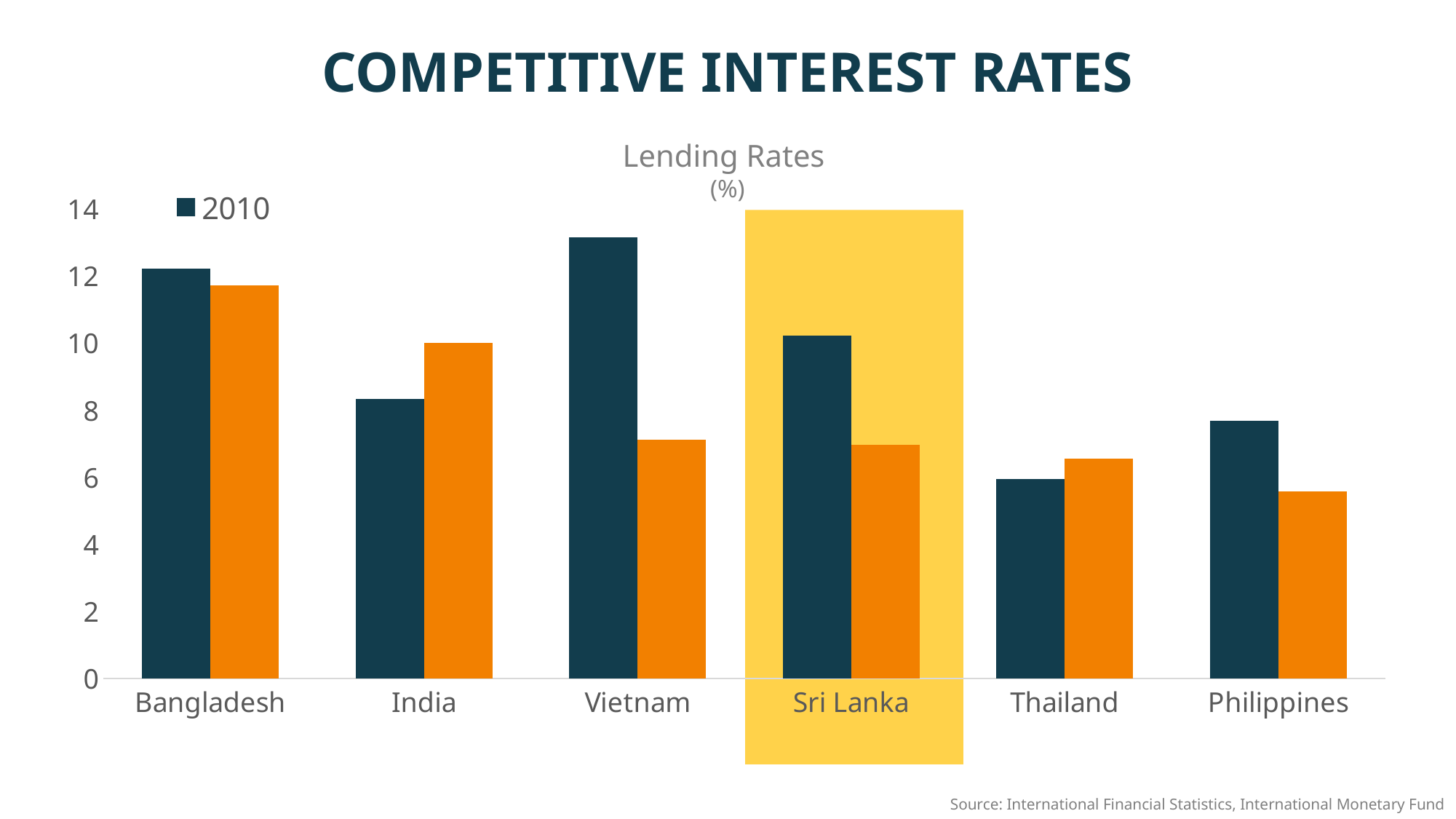
For India, which bar is taller, the dark blue 2010 bar or the orange bar? the orange bar Which country has the lowest 2010 lending rate? Thailand Which country is highlighted with a yellow box on the chart? Sri Lanka Is the 2010 lending rate for Sri Lanka greater or less than 8? greater Is the 2010 lending rate for Thailand greater or less than 8? less What is the title of the chart? Lending Rates (%) Is the 2010 lending rate for India greater or less than 10? less How many countries are shown on the x axis of the chart? 6 Which is larger, the 2010 lending rate for Vietnam or for Bangladesh? Vietnam What kind of chart is shown on the slide? bar chart Which country has the highest 2010 lending rate? Vietnam